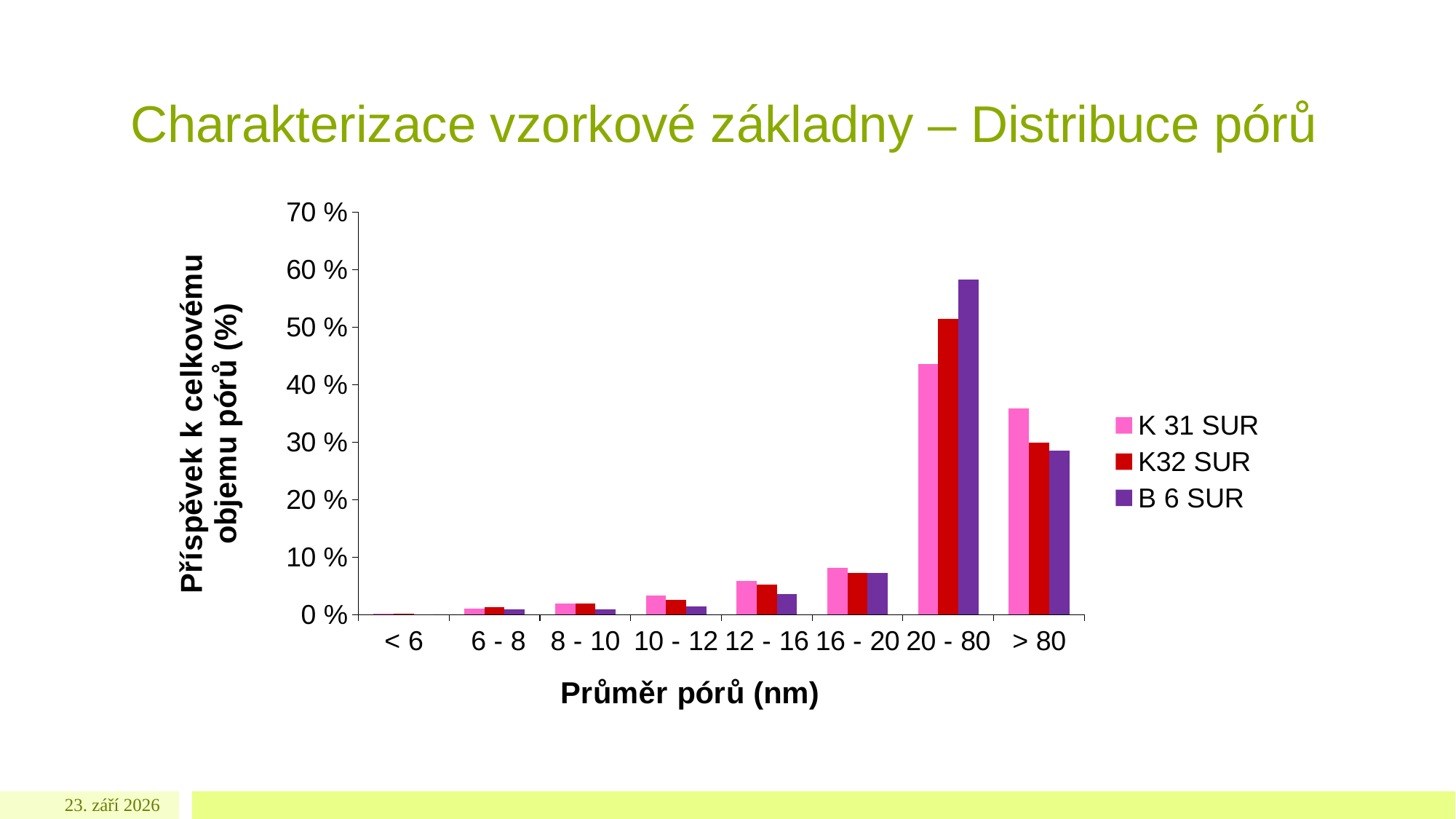
For which pore diameter category is the K 31 SUR value lowest? < 6 Is the value for K 31 SUR in the > 80 category greater or less than 30 %? greater Is the value for B 6 SUR in the 20 - 80 category greater or less than 50 %? greater What is the title of the x axis? Průměr pórů (nm) How many pore diameter categories are shown on the x axis? 8 Is the value for K 31 SUR in the 20 - 80 category greater or less than 50 %? less What kind of chart is shown on the slide? bar chart Which series has the highest value in the 20 - 80 category? B 6 SUR In the > 80 category, which is larger: K 31 SUR or B 6 SUR? K 31 SUR In the 20 - 80 category, which is larger: K32 SUR or B 6 SUR? B 6 SUR How many series does the legend list? 3 For which pore diameter category is the B 6 SUR value highest? 20 - 80